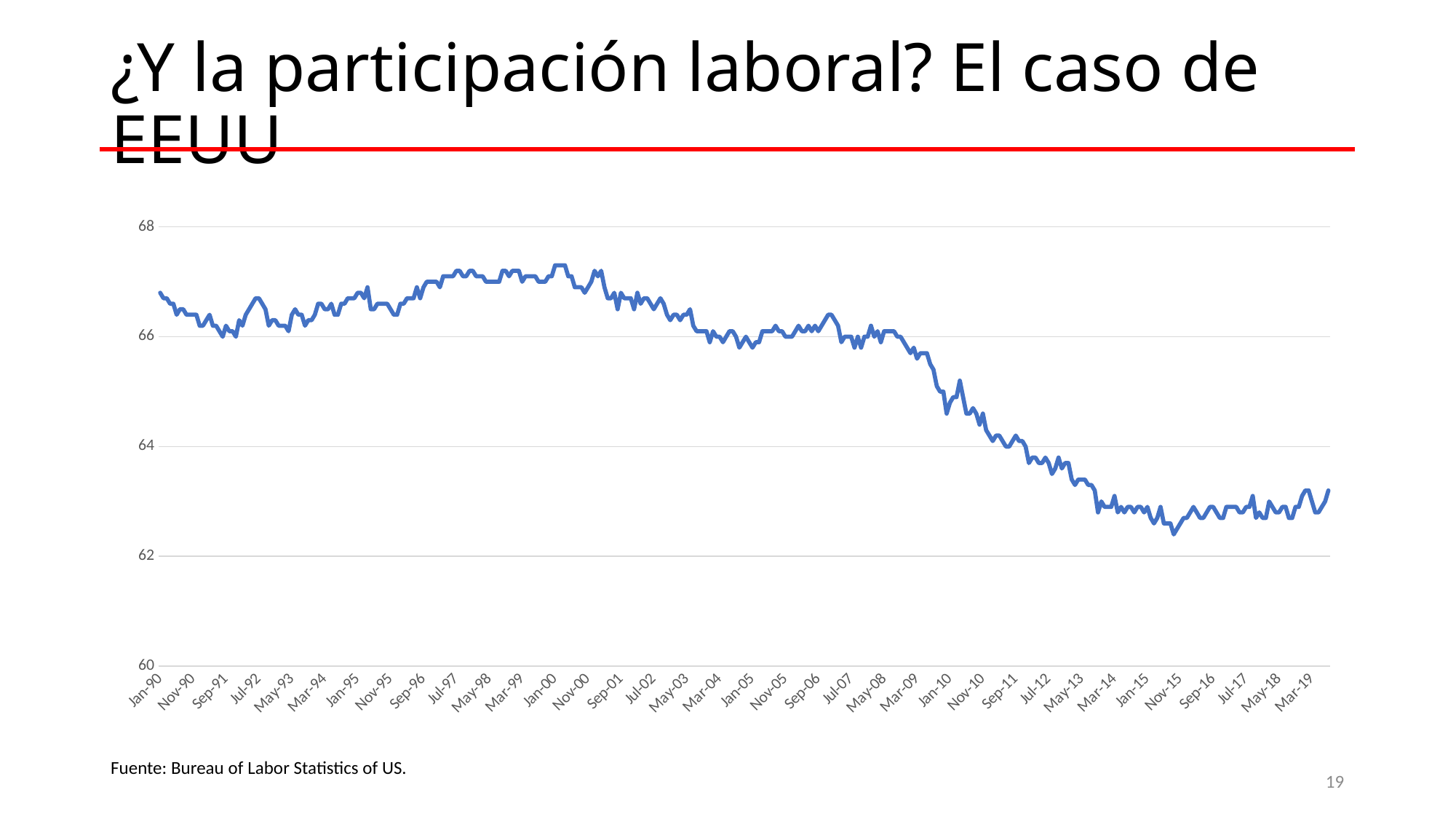
Is the value for Nov-15 greater or less than 64? less What is the highest value shown on the vertical axis? 68 Is the value for Jan-10 greater or less than 64? greater Overall, does the line rise or fall from Jan-90 to Mar-19? fall Is the value for Jan-90 greater or less than 66? greater What source is cited below the chart? Bureau of Labor Statistics of US Which is larger, the value for Jan-00 or the value for Nov-15? Jan-00 Which is larger, the value for Jan-90 or the value for Mar-19? Jan-90 What kind of chart is shown on the slide? line chart